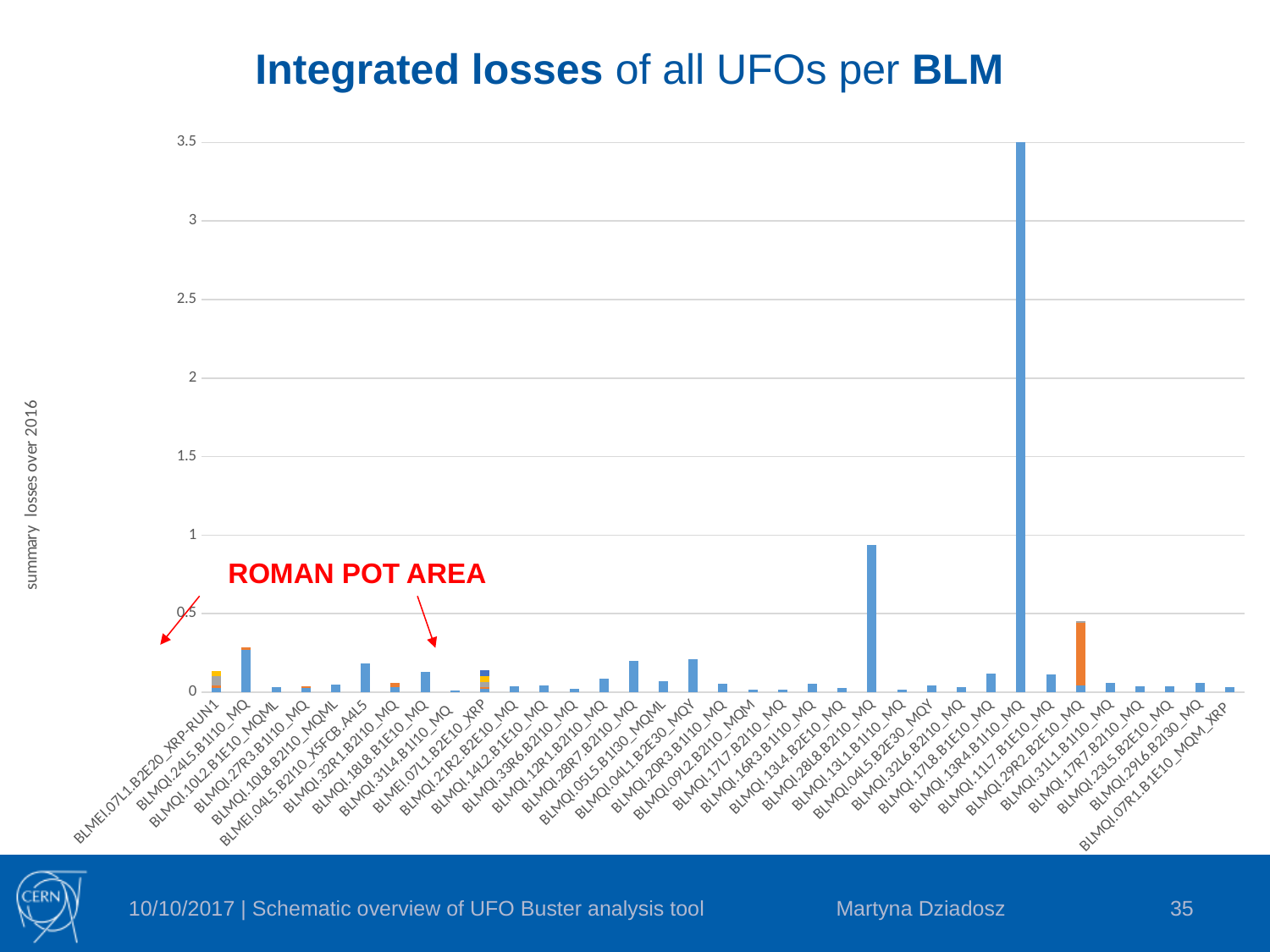
What kind of chart is shown on the slide? bar chart What is the highest value shown on the y axis of the chart? 3.5 Which is larger, the value for BLMQI.11L7.B1E10_MQ or the value for BLMQI.13L1.B1I10_MQ? BLMQI.11L7.B1E10_MQ Which BLM has the highest integrated losses in the chart? BLMQI.13R4.B1I10_MQ Is the value for BLMQI.11L7.B1E10_MQ greater or less than 3? less Is the value for BLMQI.29R2.B2E10_MQ greater or less than 0.5? less How many BLM categories are plotted along the x axis of the chart? 35 Is the value of the tallest bar in the chart greater or less than 3? greater What is the title of the chart on the slide? Integrated losses of all UFOs per BLM What text is written in red above the chart's left-hand bars? ROMAN POT AREA